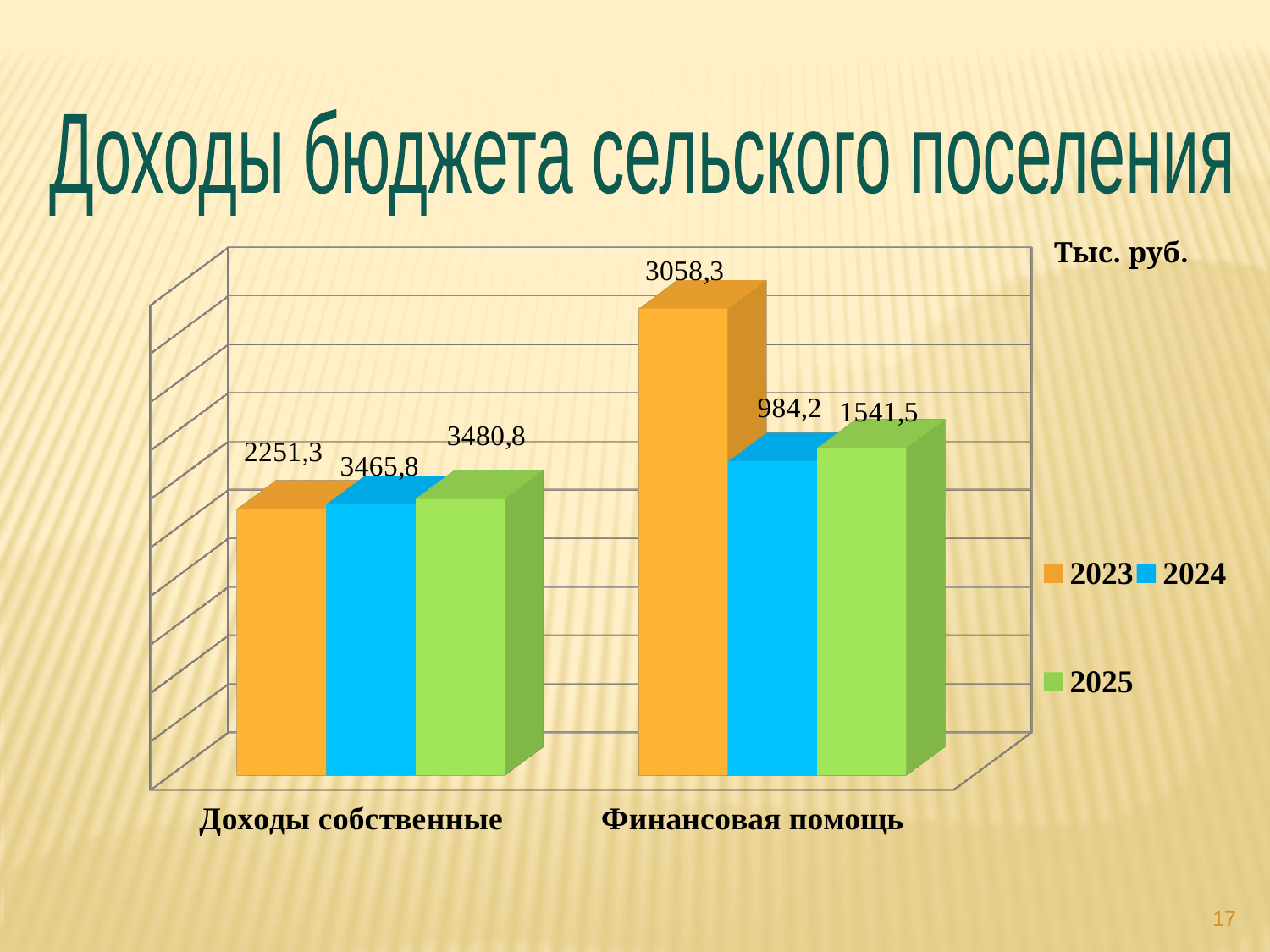
What is the value for 2025 in the "Финансовая помощь" category? 1541,5 Which year has the lowest value in the "Финансовая помощь" category? 2024 Which year has the highest value in the "Финансовая помощь" category? 2023 What is the value for 2024 in the "Доходы собственные" category? 3465,8 What is the difference between the 2023 and 2024 values in the "Финансовая помощь" category? 2074,1 How many series does the legend list? 3 What is the value for 2023 in the "Финансовая помощь" category? 3058,3 What is the value for 2024 in the "Финансовая помощь" category? 984,2 What is the value for 2023 in the "Доходы собственные" category? 2251,3 Which is larger in the "Доходы собственные" category: the 2023 value or the 2024 value? 2024 What kind of chart is shown on the slide? Bar chart What is the value for 2025 in the "Доходы собственные" category? 3480,8